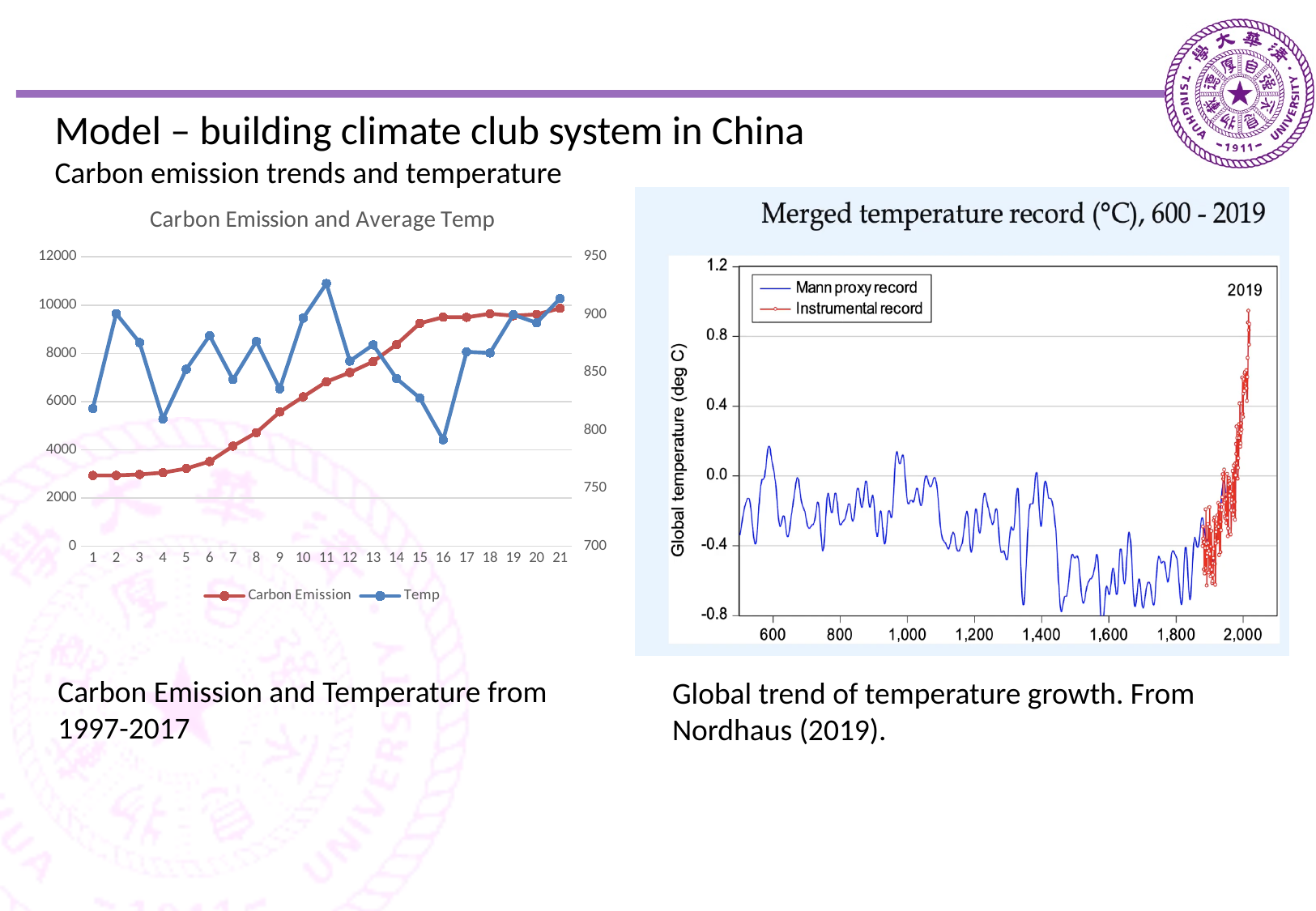
On the left chart "Carbon Emission and Average Temp", is the Carbon Emission value at point 21 greater or less than 8000 on the left axis? greater On the left chart "Carbon Emission and Average Temp", at which x-axis point is the Temp series lowest? 16 On the left chart "Carbon Emission and Average Temp", at which x-axis point is the Temp series highest? 11 On the left chart "Carbon Emission and Average Temp", how many series does the legend list? 2 On the right chart "Merged temperature record (°C), 600 - 2019", what is the label on the y axis? Global temperature (deg C) On the left chart "Carbon Emission and Average Temp", is the Carbon Emission value at point 1 greater or less than 4000 on the left axis? less On the left chart "Carbon Emission and Average Temp", how many points are plotted along the x axis for each series? 21 On the right chart "Merged temperature record (°C), 600 - 2019", does the Instrumental record rise or fall toward the end of the x axis? rise On the right chart "Merged temperature record (°C), 600 - 2019", what are the two series named in the legend? Mann proxy record and Instrumental record On the left chart "Carbon Emission and Average Temp", which is larger: the Temp value at point 2 or at point 4? point 2 On the left chart titled "Carbon Emission and Average Temp", what kind of chart is it? line chart On the left chart "Carbon Emission and Average Temp", does the Carbon Emission series generally rise or fall along the x axis? rise